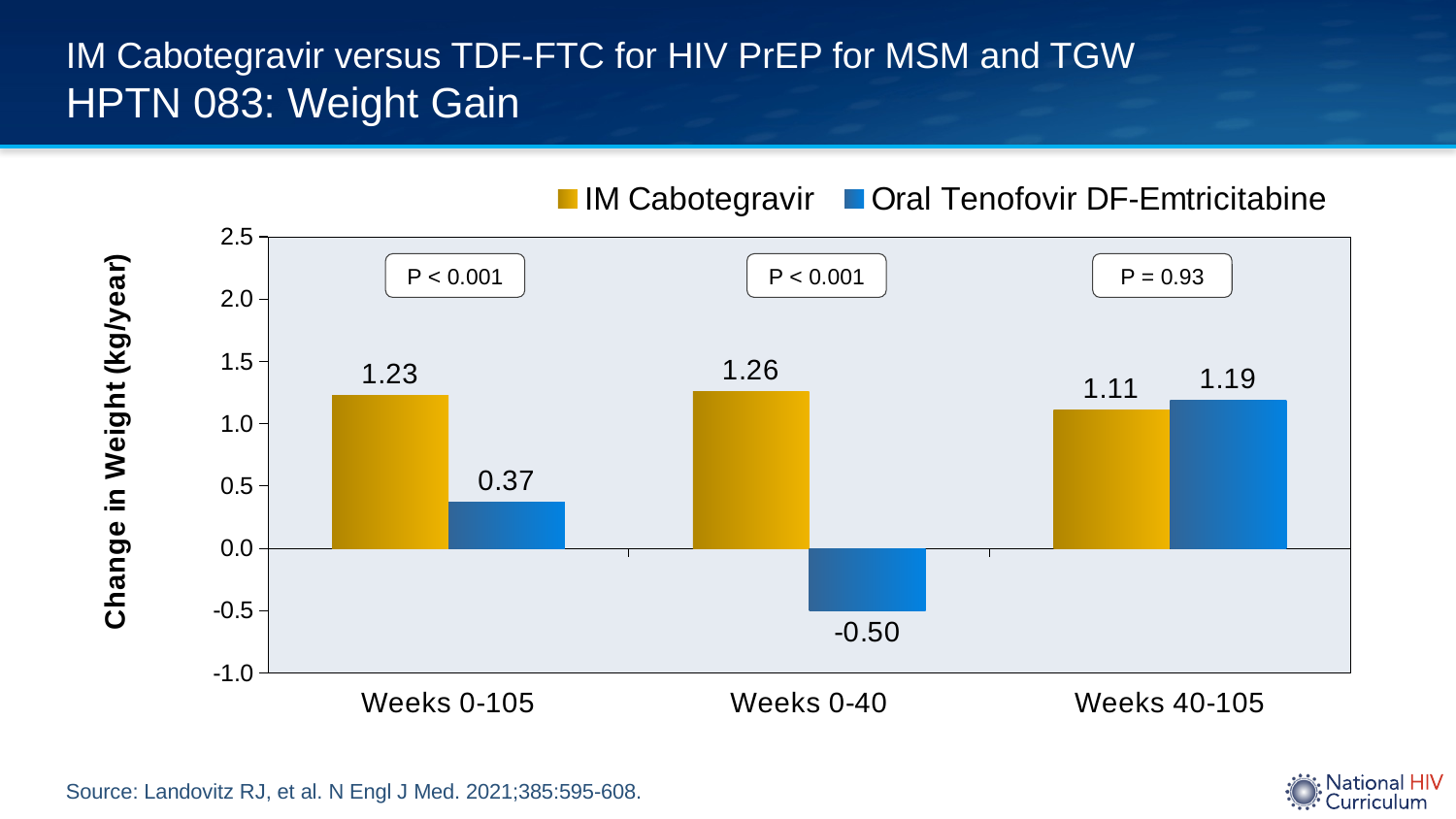
What is the change in weight for Oral Tenofovir DF-Emtricitabine during Weeks 40-105? 1.19 What kind of chart is shown on the slide? Bar chart Which time period has the highest change in weight for IM Cabotegravir? Weeks 0-40 What is the change in weight for Oral Tenofovir DF-Emtricitabine during Weeks 0-40? -0.50 How many series does the legend list? 2 What is the difference between the IM Cabotegravir and Oral Tenofovir DF-Emtricitabine values for Weeks 0-105? 0.86 For Weeks 40-105, which series has the larger change in weight, IM Cabotegravir or Oral Tenofovir DF-Emtricitabine? Oral Tenofovir DF-Emtricitabine What is the change in weight for IM Cabotegravir during Weeks 0-105? 1.23 Is the value for IM Cabotegravir during Weeks 0-40 greater or less than 1.0? greater What P value is shown for the Weeks 40-105 comparison? P = 0.93 How many time periods are shown on the x axis? 3 Which time period has the lowest change in weight for Oral Tenofovir DF-Emtricitabine? Weeks 0-40